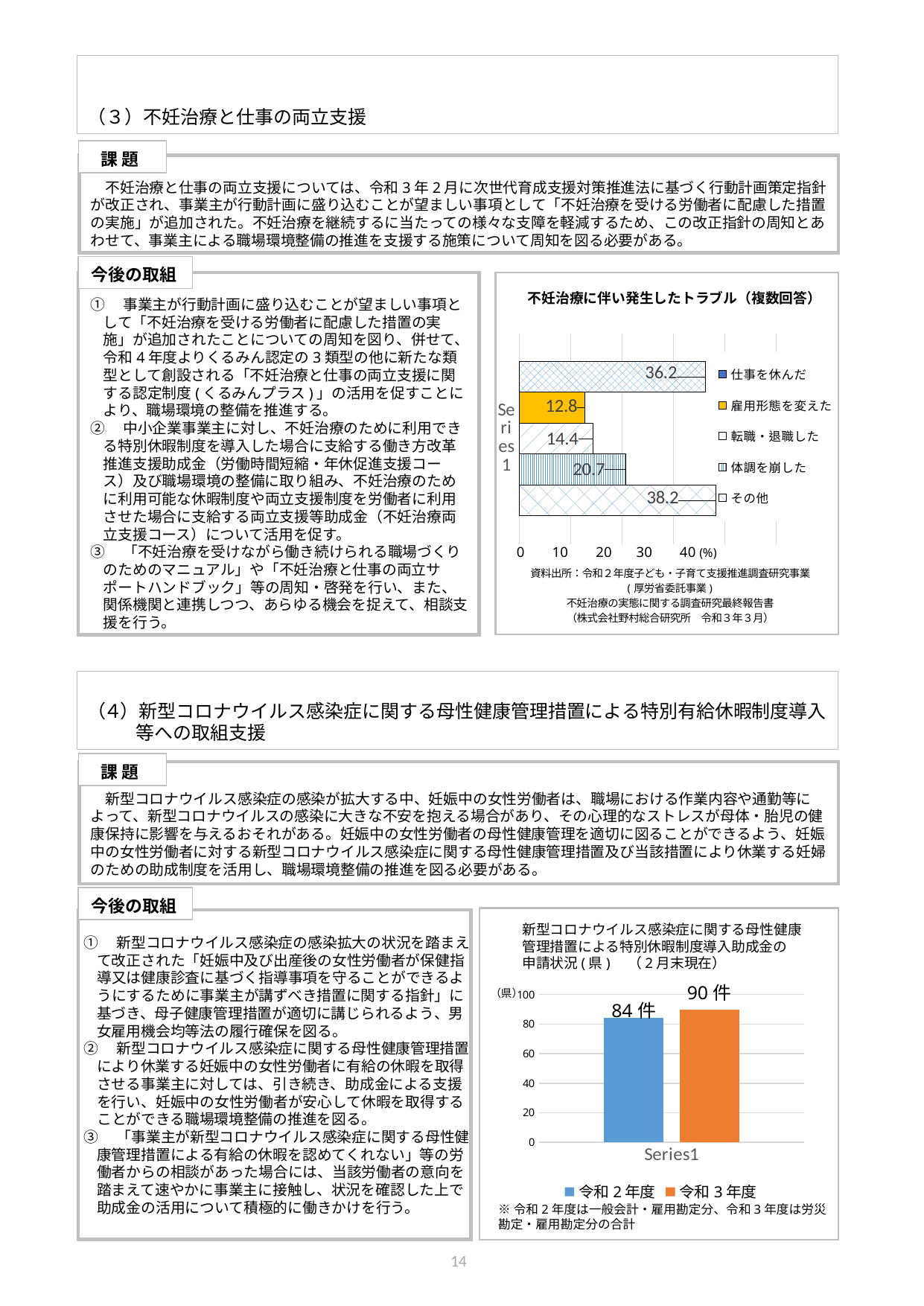
In the chart at the bottom right about 特別休暇制度導入助成金の申請状況, what is the value for 令和3年度? 90件 In the chart at the bottom right about 特別休暇制度導入助成金の申請状況, what is the difference between the values for 令和3年度 and 令和2年度? 6件 In the chart titled 不妊治療に伴い発生したトラブル（複数回答）, what is the value for 仕事を休んだ? 36.2 In the chart titled 不妊治療に伴い発生したトラブル（複数回答）, which is larger: 転職・退職した or 体調を崩した? 体調を崩した In the chart at the bottom right about 特別休暇制度導入助成金の申請状況, what is the value for 令和2年度? 84件 In the chart titled 不妊治療に伴い発生したトラブル（複数回答）, which category has the highest value? その他 In the chart titled 不妊治療に伴い発生したトラブル（複数回答）, what is the value for 雇用形態を変えた? 12.8 In the chart titled 不妊治療に伴い発生したトラブル（複数回答）, how many categories does the legend list? 5 What kind of chart is the chart titled 不妊治療に伴い発生したトラブル（複数回答）? Bar chart In the chart titled 不妊治療に伴い発生したトラブル（複数回答）, what is the difference between the values for その他 and 仕事を休んだ? 2.0 In the chart titled 不妊治療に伴い発生したトラブル（複数回答）, which category has the lowest value? 雇用形態を変えた In the chart titled 不妊治療に伴い発生したトラブル（複数回答）, what is the value for 体調を崩した? 20.7